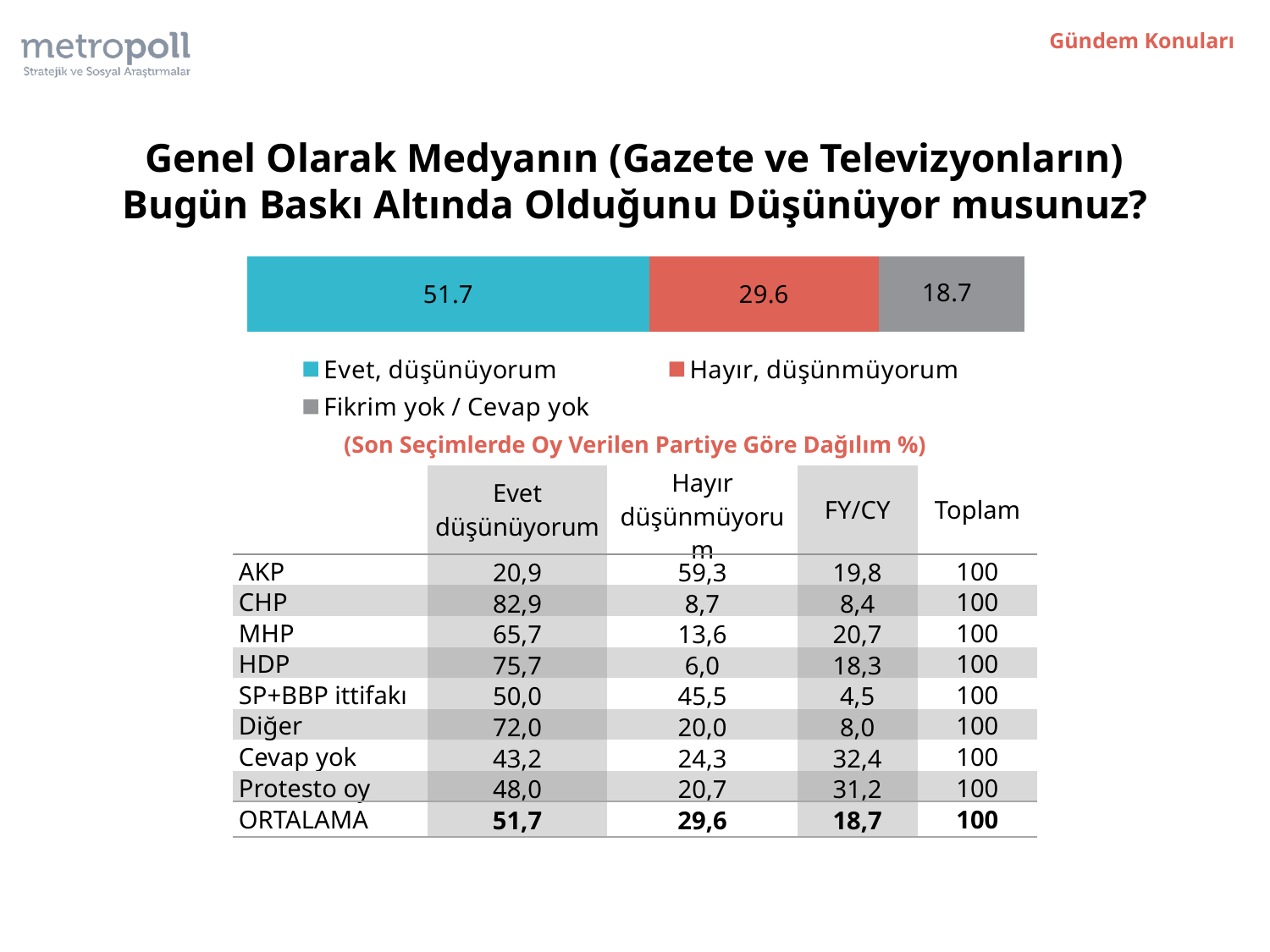
How many series does the legend of the stacked bar chart list? 3 What is the total of the three segments in the stacked bar chart? 100 What value is shown for "Hayır, düşünmüyorum" in the stacked bar chart? 29.6 Which segment of the stacked bar has the lowest value? Fikrim yok / Cevap yok What is the difference between the "Hayır, düşünmüyorum" and "Fikrim yok / Cevap yok" values in the stacked bar chart? 10.9 What value is shown for "Evet, düşünüyorum" in the stacked bar chart? 51.7 What value is shown for "Fikrim yok / Cevap yok" in the stacked bar chart? 18.7 Which is larger in the stacked bar chart: "Hayır, düşünmüyorum" or "Fikrim yok / Cevap yok"? Hayır, düşünmüyorum Which segment of the stacked bar has the highest value? Evet, düşünüyorum What colour is the "Hayır, düşünmüyorum" segment in the stacked bar chart? Red What is the difference between the "Evet, düşünüyorum" and "Hayır, düşünmüyorum" values in the stacked bar chart? 22.1 What kind of chart is shown on the slide? Stacked bar chart